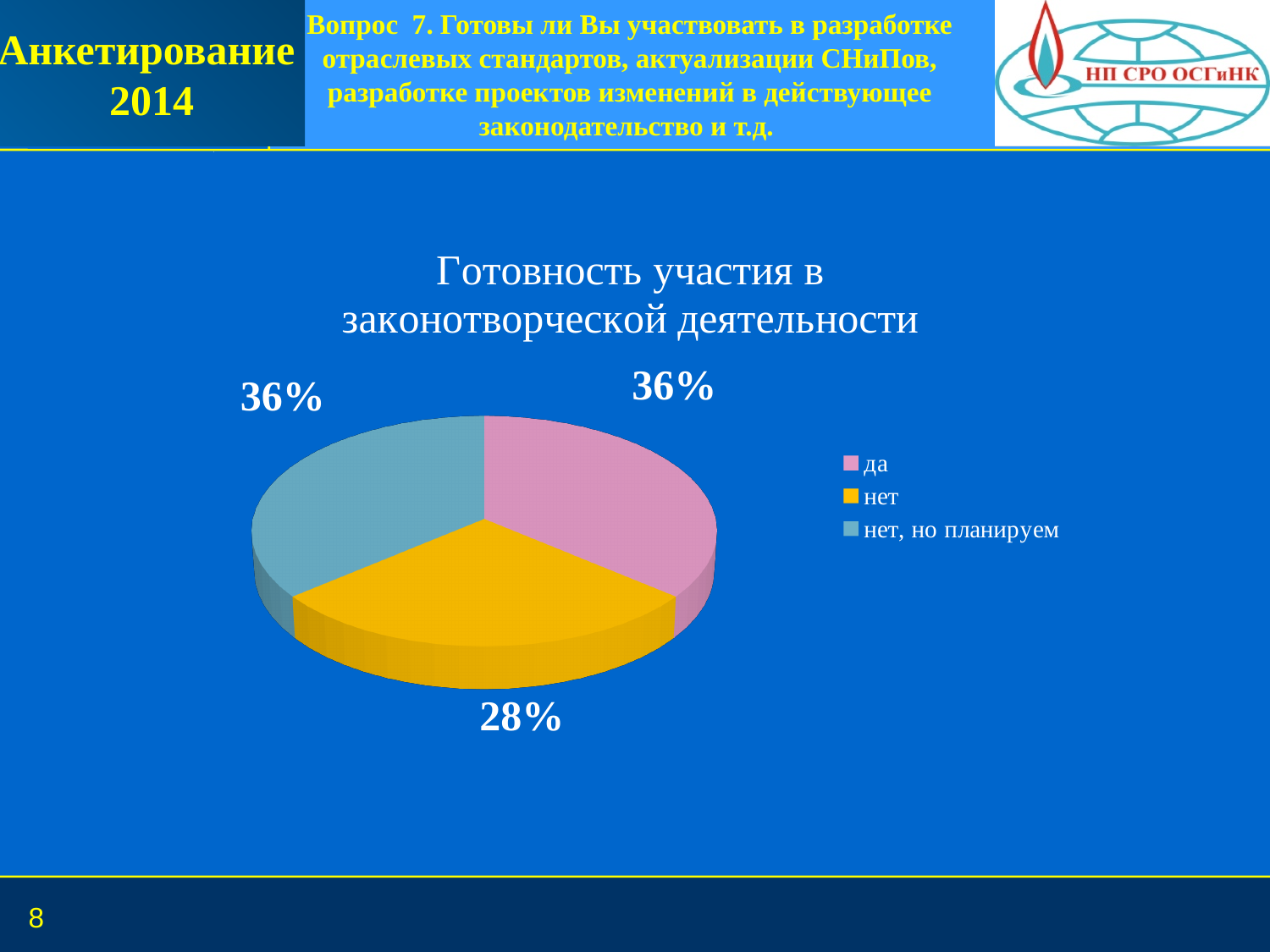
Which answer has the smallest share of the pie? нет Which is larger: the share for "нет, но планируем" or the share for "нет"? нет, но планируем What share of respondents answered "да"? 36% What is the title of the chart? Готовность участия в законотворческой деятельности What share of respondents answered "нет, но планируем"? 36% What is the difference in percentage points between the "да" slice and the "нет" slice? 8 What share of respondents answered "нет"? 28% How many slices does the pie chart have? 3 How many entries does the legend list? 3 Is the share for "нет" greater or less than 30%? less Which colour represents the "нет" slice in the pie chart? yellow What type of chart is shown on the slide? pie chart